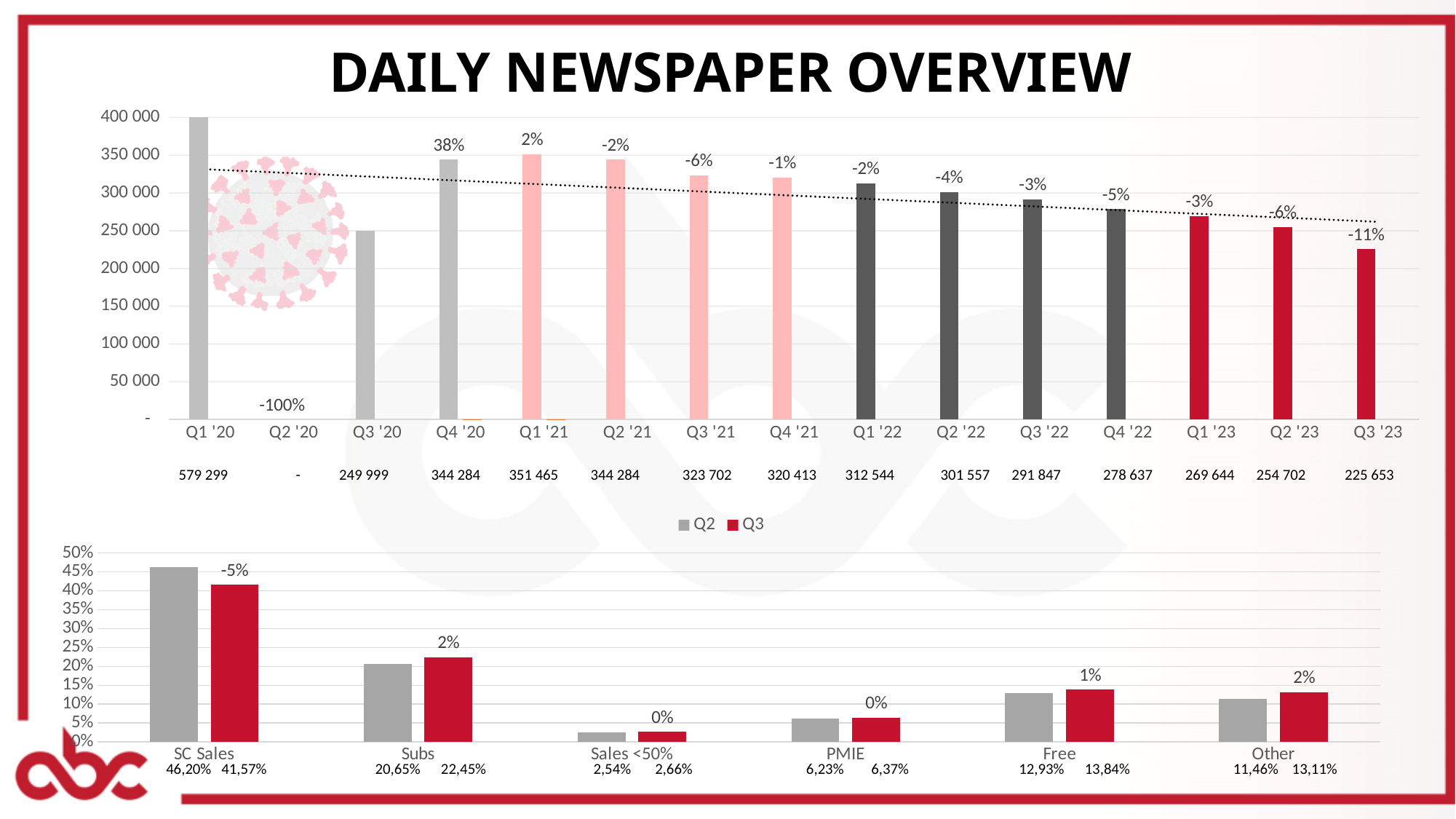
In the top chart, is the bar for Q4 '22 greater or less than 300 000? less In the top chart, what is the difference between the values for Q1 '21 and Q3 '23? 125 812 In the bottom chart, what is the difference between the Q2 and Q3 values for SC Sales? 4,63% What kind of chart is the bottom chart? bar chart In the top chart, how many quarters are shown on the x axis? 15 In the bottom chart, which category has the highest Q3 value? SC Sales In the top chart, do the values rise or fall from Q1 '21 to Q3 '23? fall In the bottom chart, what is the Q3 value for Subs? 22,45% How many series does the legend of the bottom chart list? 2 In the top chart, what is the value shown for Q3 '23? 225 653 In the top chart, what percentage change is labelled above the Q4 '20 bar? 38% In the bottom chart, which has the larger Q2 value, Free or Other? Free